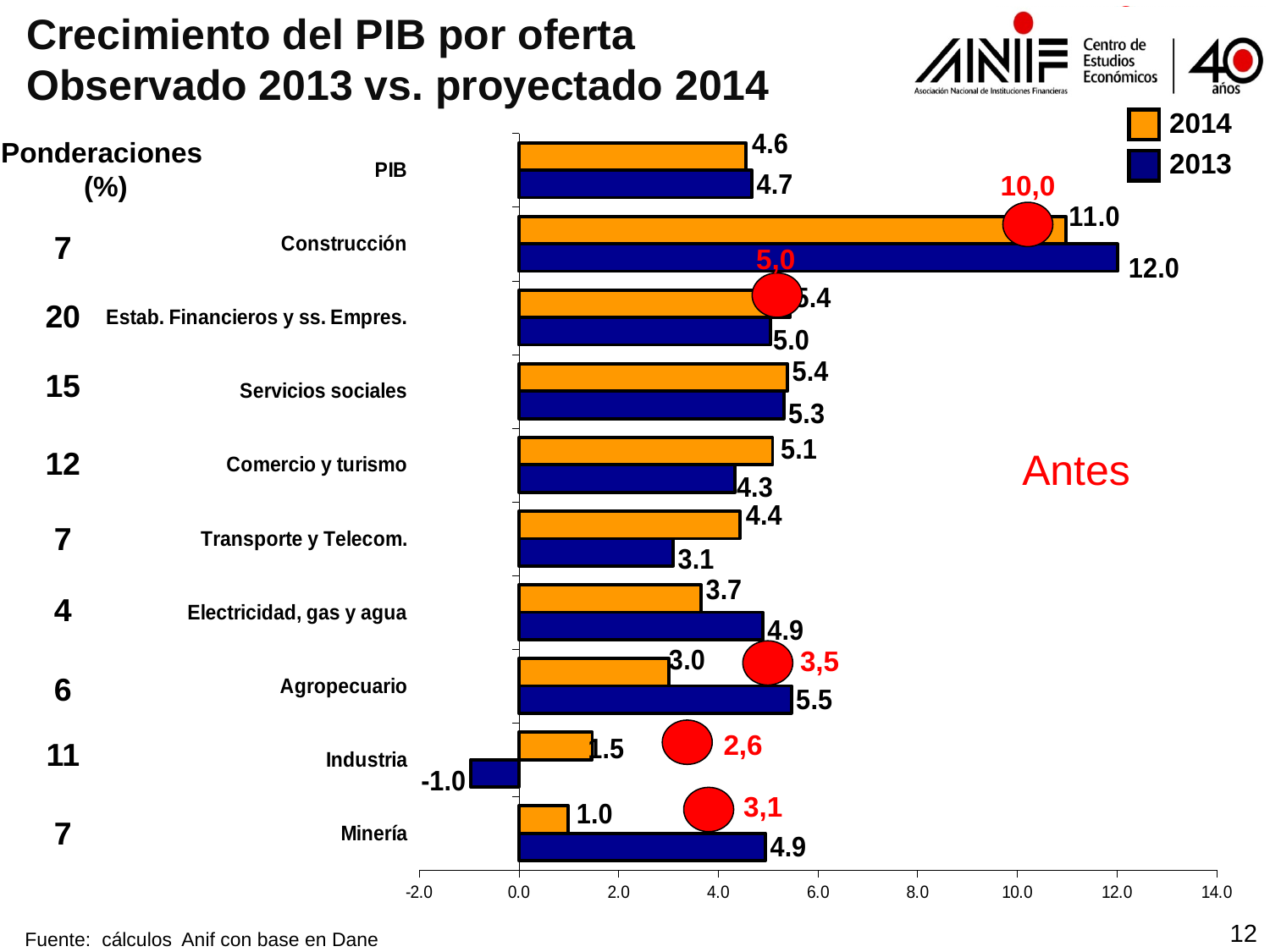
How many categories are shown on the chart? 10 What is the difference between the 2013 and 2014 values for Minería? 3.9 For Comercio y turismo, which is larger: the 2014 value or the 2013 value? 2014 Which category has the highest 2014 value? Construcción What is the 2013 value for Construcción? 12.0 What is the 2014 value for Agropecuario? 3.0 What is the 2013 value for Industria? -1.0 What is the 2014 value for Minería? 1.0 What kind of chart is shown on the slide? Bar chart How many series does the legend list? 2 What is the 'Antes' value shown in the red circle for Construcción? 10,0 Which category has the lowest 2013 value? Industria